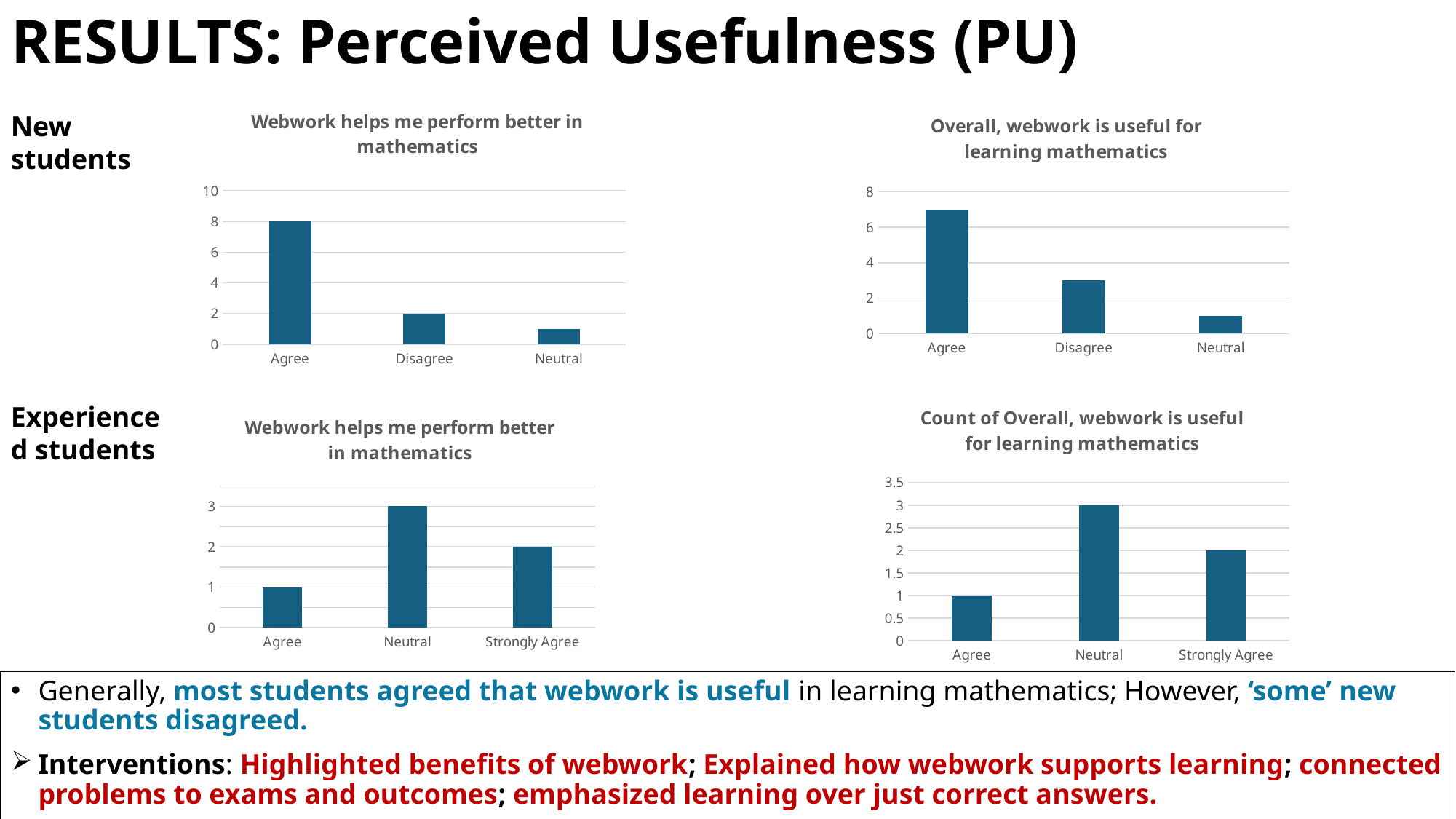
In the top-left chart 'Webwork helps me perform better in mathematics' (new students), what is the difference between Agree and Disagree? 6 In the top-left chart 'Webwork helps me perform better in mathematics' (new students), what is the value for Disagree? 2 In the top-left chart 'Webwork helps me perform better in mathematics' (new students), what is the value for Agree? 8 In the top-left chart 'Webwork helps me perform better in mathematics' (new students), which category has the lowest value? Neutral How many categories are shown in the bottom-right chart 'Count of Overall, webwork is useful for learning mathematics'? 3 In the top-right chart 'Overall, webwork is useful for learning mathematics' (new students), is the value for Disagree larger than the value for Neutral? Yes In the top-right chart 'Overall, webwork is useful for learning mathematics' (new students), is the value for Agree greater or less than 6? greater In the bottom-left chart 'Webwork helps me perform better in mathematics' (experienced students), which category has the lowest value? Agree What type of chart is the top-left chart 'Webwork helps me perform better in mathematics'? bar chart In the bottom-right chart 'Count of Overall, webwork is useful for learning mathematics' (experienced students), what is the value for Strongly Agree? 2 In the top-right chart 'Overall, webwork is useful for learning mathematics' (new students), which category has the highest value? Agree In the bottom-left chart 'Webwork helps me perform better in mathematics' (experienced students), what is the value for Neutral? 3